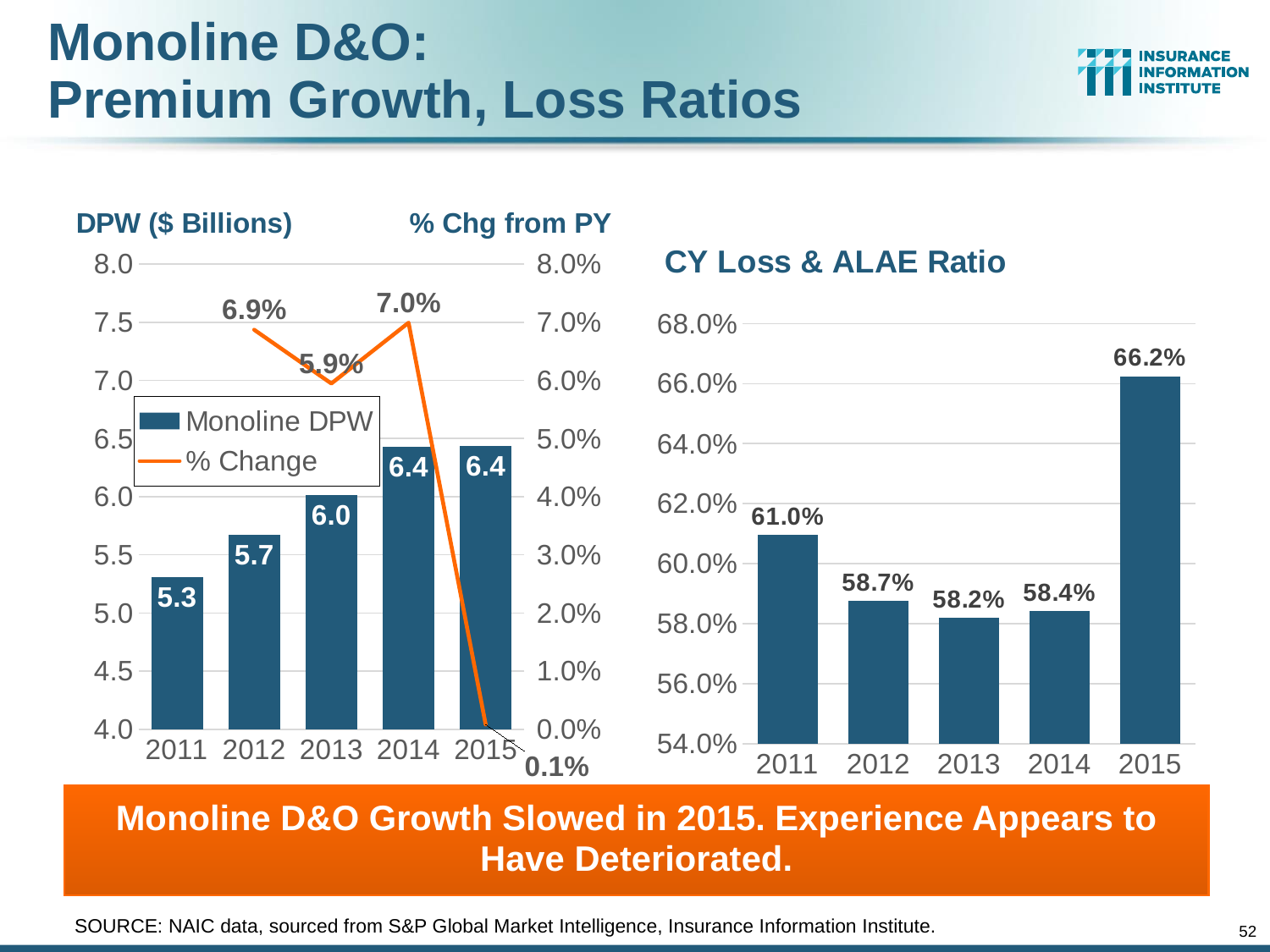
In the left chart, how many series does the legend list? 2 What kind of chart is the CY Loss & ALAE Ratio chart? bar chart In the left chart, which year has the lowest Monoline DPW? 2011 In the left chart, what is the difference in Monoline DPW between 2013 and 2012? 0.3 In the CY Loss & ALAE Ratio chart, what is the value for 2013? 58.2% In the CY Loss & ALAE Ratio chart, what is the difference between the 2015 and 2014 values? 7.8% In the CY Loss & ALAE Ratio chart, how many years are shown? 5 In the CY Loss & ALAE Ratio chart, which year has the highest ratio? 2015 In the left chart, what is the % Change value for 2015? 0.1% In the left chart, does the Monoline DPW rise or fall from 2011 to 2014? rise In the left chart, what is the % Change value for 2014? 7.0% In the left chart, what is the Monoline DPW value for 2011? 5.3